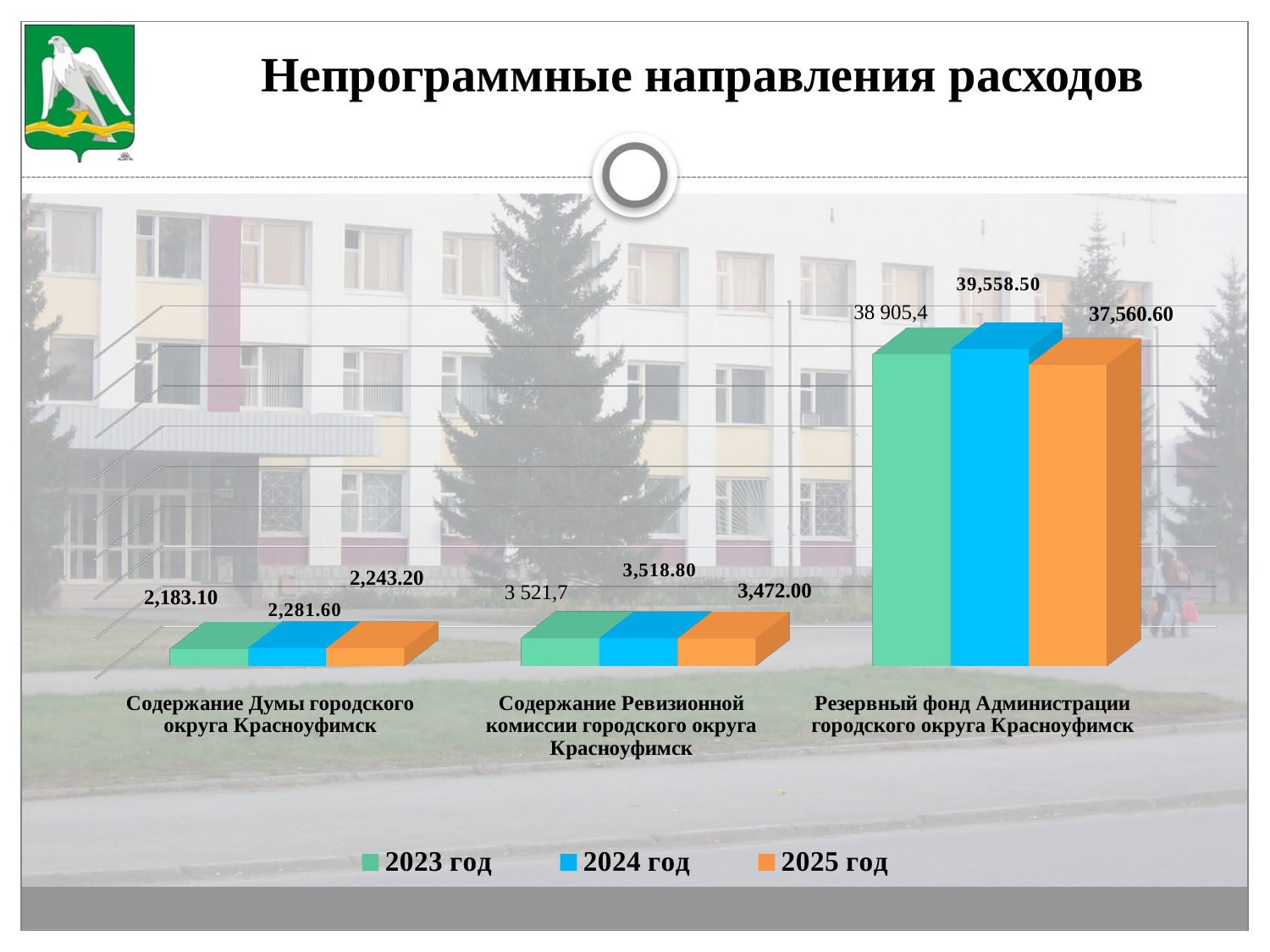
Which category has the lowest values across all years? Содержание Думы городского округа Красноуфимск What is the value for 2023 год for Содержание Ревизионной комиссии городского округа Красноуфимск? 3 521,7 How many categories are shown on the x axis? 3 What is the difference between the 2024 год and 2025 год values for Резервный фонд Администрации городского округа Красноуфимск? 1,997.90 What kind of chart is shown on the slide? Bar chart Which category has the highest values across all years? Резервный фонд Администрации городского округа Красноуфимск For Резервный фонд Администрации городского округа Красноуфимск, which year has the highest value? 2024 год What is the value for 2024 год for Резервный фонд Администрации городского округа Красноуфимск? 39,558.50 How many series does the legend list? 3 What is the value for 2025 год for Резервный фонд Администрации городского округа Красноуфимск? 37,560.60 Which is larger for Содержание Думы городского округа Красноуфимск: the 2023 год value or the 2025 год value? 2025 год What is the value for 2024 год for Содержание Думы городского округа Красноуфимск? 2,281.60